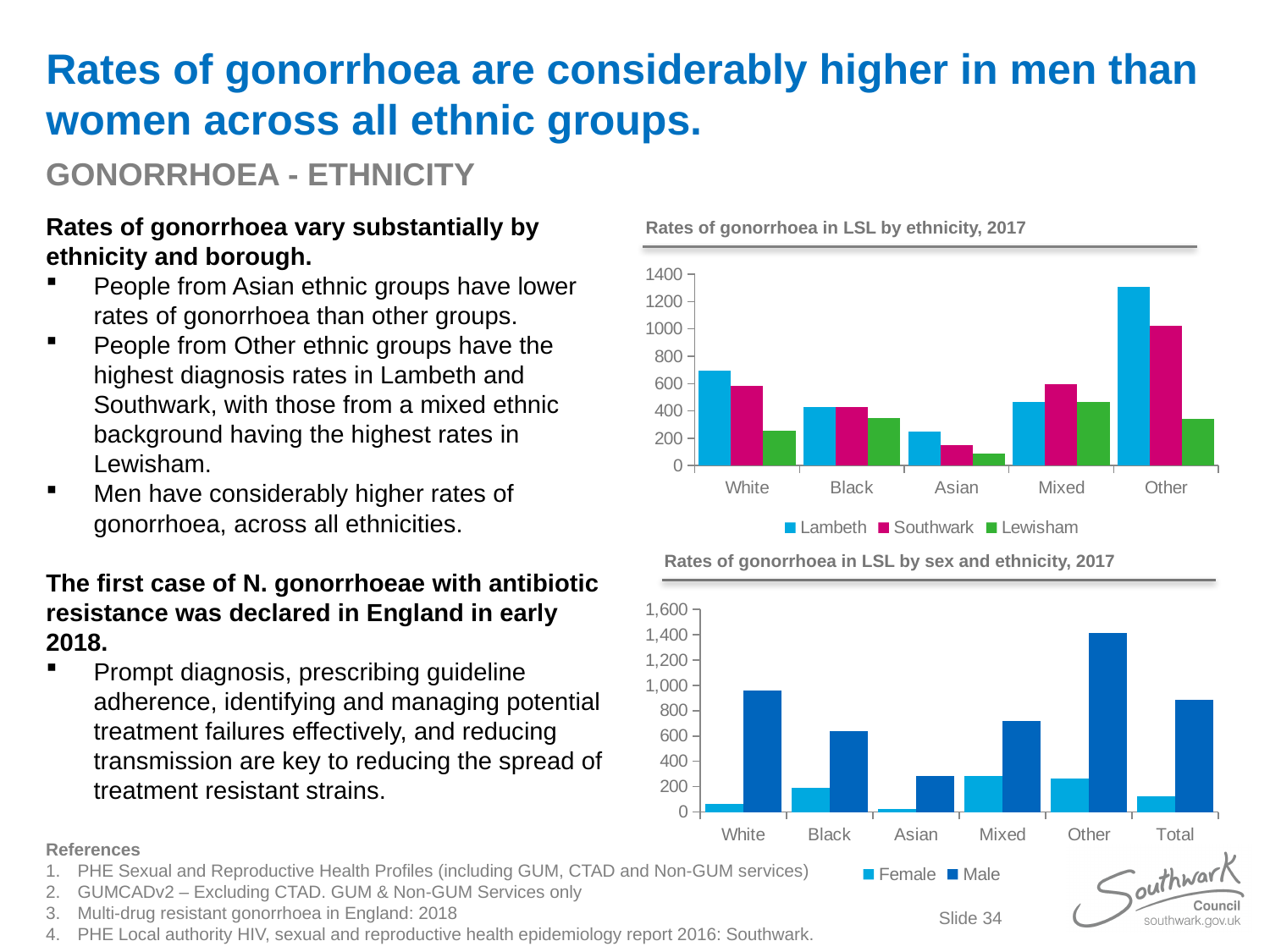
In the chart 'Rates of gonorrhoea in LSL by ethnicity, 2017', which colour represents Lewisham in the legend? green In the chart 'Rates of gonorrhoea in LSL by ethnicity, 2017', which ethnic group has the lowest rate for Lewisham? Asian In the chart 'Rates of gonorrhoea in LSL by sex and ethnicity, 2017', which category has the lowest Female value? Asian In the chart 'Rates of gonorrhoea in LSL by ethnicity, 2017', is the Lambeth value for Other greater or less than 1200? greater In the chart 'Rates of gonorrhoea in LSL by sex and ethnicity, 2017', how many series does the legend list? 2 In the chart 'Rates of gonorrhoea in LSL by ethnicity, 2017', how many series does the legend list? 3 What kind of chart is 'Rates of gonorrhoea in LSL by ethnicity, 2017'? bar chart In the chart 'Rates of gonorrhoea in LSL by ethnicity, 2017', which ethnic group has the highest rate for Lambeth? Other In the chart 'Rates of gonorrhoea in LSL by ethnicity, 2017', for the Mixed group, which is larger: Lambeth or Southwark? Southwark In the chart 'Rates of gonorrhoea in LSL by sex and ethnicity, 2017', how many categories are shown on the x axis? 6 In the chart 'Rates of gonorrhoea in LSL by ethnicity, 2017', how many ethnic group categories are shown on the x axis? 5 In the chart 'Rates of gonorrhoea in LSL by sex and ethnicity, 2017', is the Male value for Other greater or less than 1,200? greater